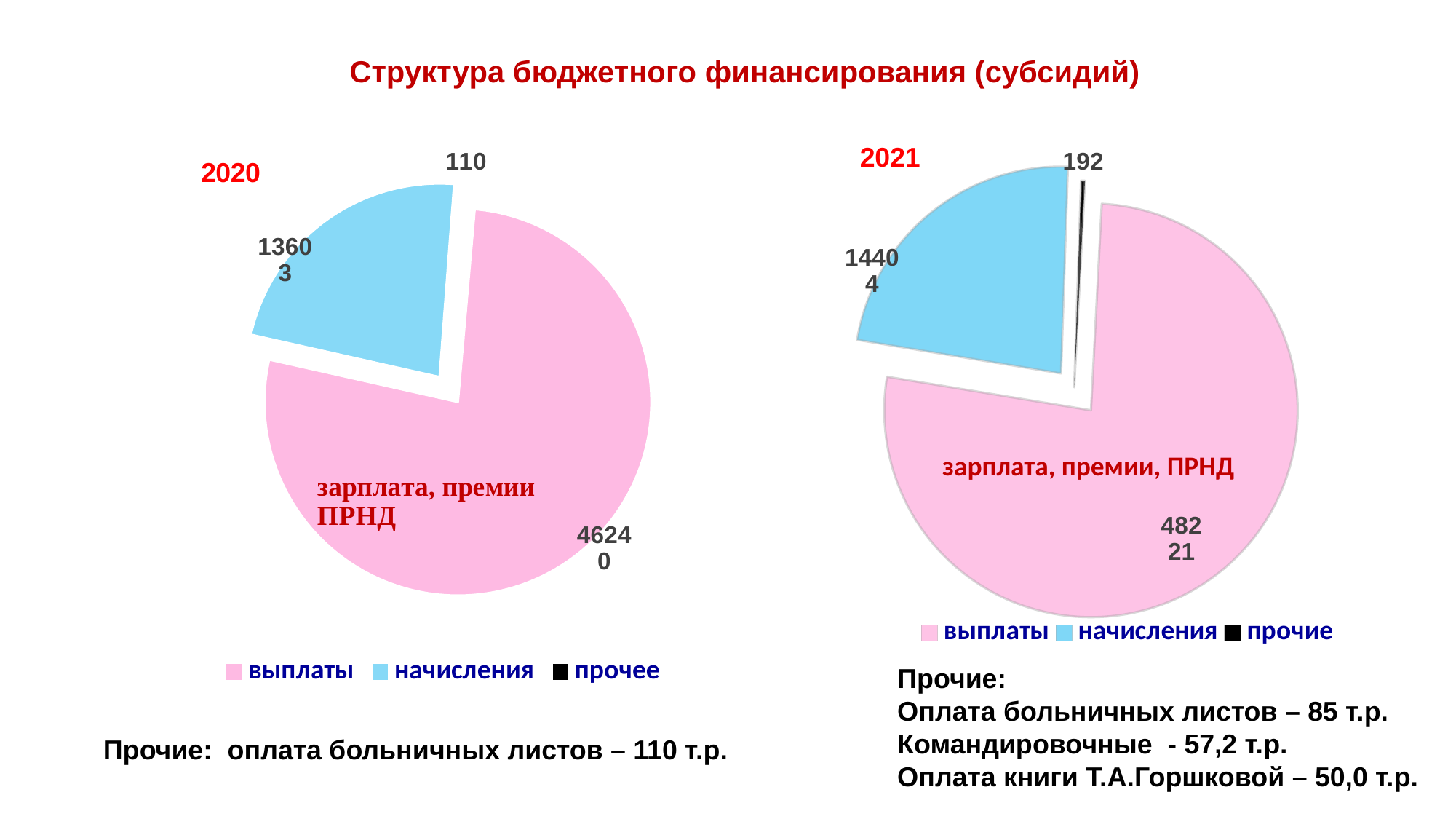
Which is larger: прочее in the 2020 chart or прочие in the 2021 chart? прочие in 2021 In the 2020 pie chart, which category has the smallest slice? прочее How many entries does the legend of the 2021 pie chart list? 3 In the 2020 pie chart, what is the value for начисления? 13603 In the 2021 pie chart, what is the value for прочие? 192 In the 2021 pie chart, what is the value for выплаты? 48221 In the 2021 pie chart, which category has the largest slice? выплаты In the 2020 pie chart, what is the value for выплаты? 46240 What kind of chart is the 2020 chart on the left? pie chart In the 2020 pie chart, what is the value for прочее? 110 In the 2021 pie chart, what is the value for начисления? 14404 In the 2020 pie chart, what is the difference between выплаты and начисления? 32637